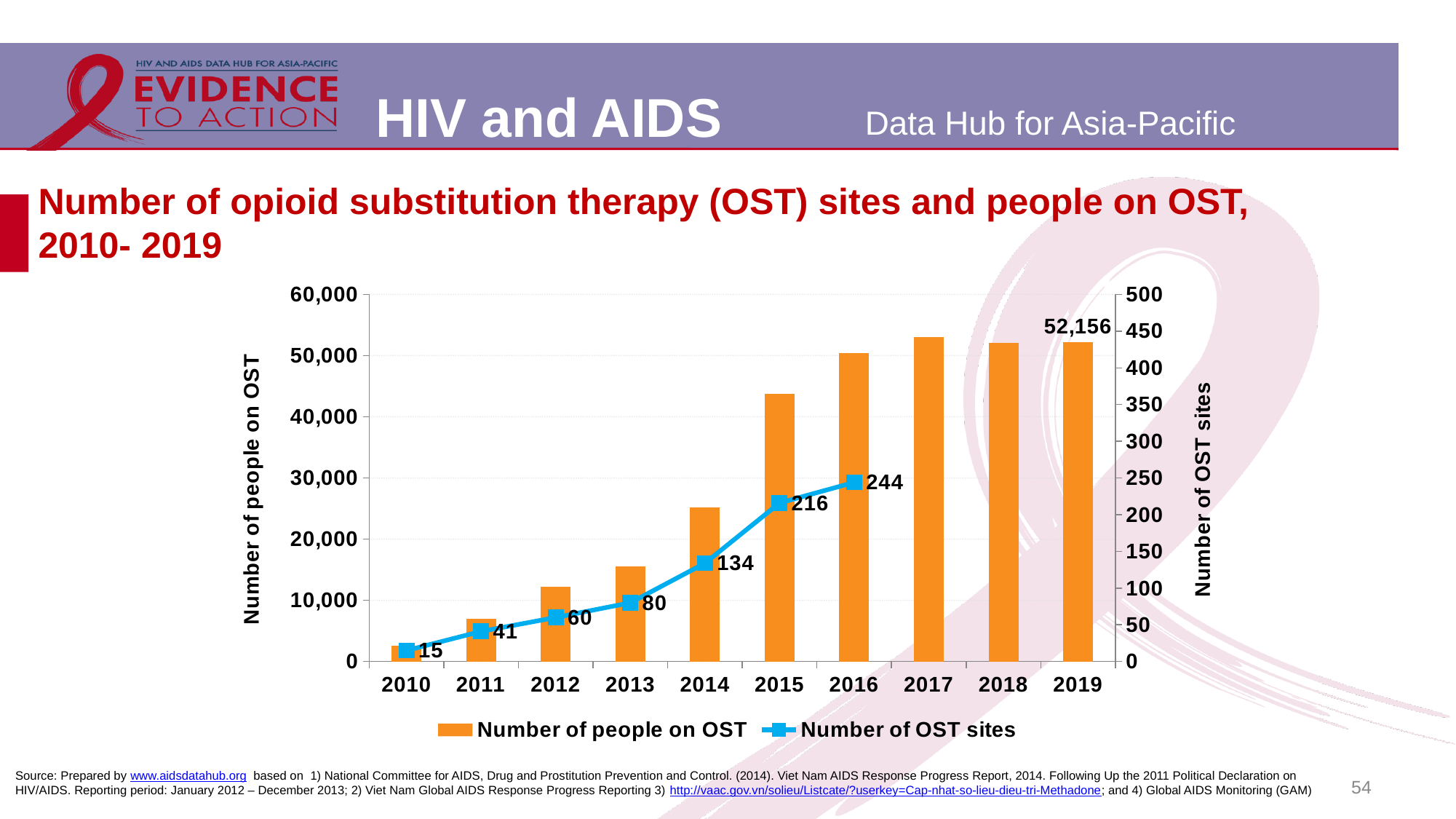
How many years are shown on the x axis? 10 How does the number of OST sites change from 2010 to 2016? It rises How many series does the legend list? 2 What is the difference in the number of OST sites between 2013 and 2014? 54 How many OST sites were there in 2014? 134 What is the number of people on OST in 2019? 52,156 By how much did the number of OST sites increase from 2015 to 2016? 28 What is the number of OST sites in 2010? 15 Which year has the highest labelled number of OST sites? 2016 Is the number of people on OST in 2014 greater or less than 20,000? greater What is the number of OST sites in 2016? 244 Which year has the lowest number of people on OST? 2010